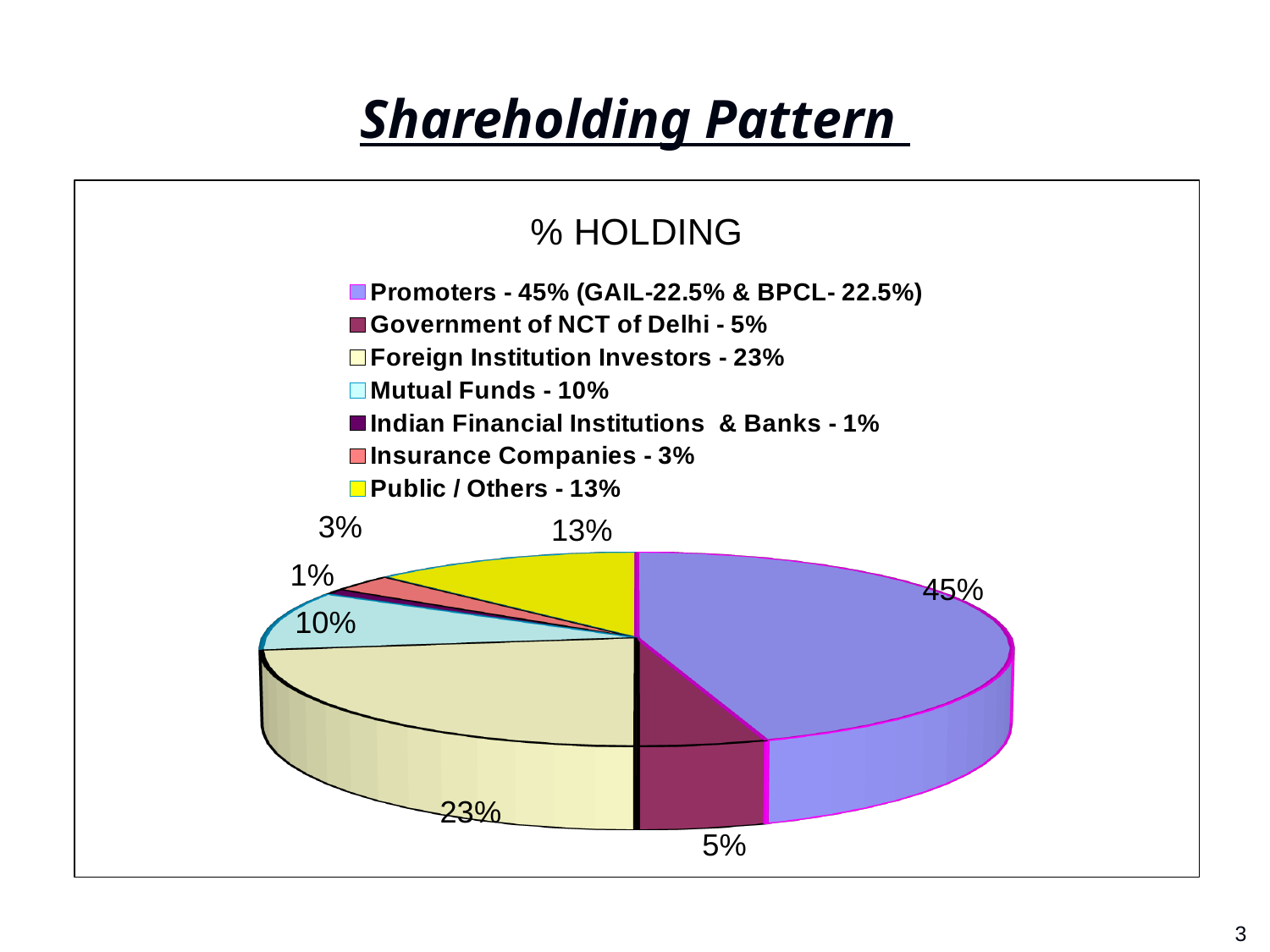
Which has a larger share, Public / Others or Mutual Funds? Public / Others What share of holding do Mutual Funds have? 10% What share of holding do Promoters have? 45% What kind of chart is shown on the slide? pie chart What is the difference between the Promoters' share and the Foreign Institution Investors' share? 22% What share of holding do Foreign Institution Investors have? 23% How many categories does the legend list? 7 What is the combined share of Insurance Companies and Indian Financial Institutions & Banks? 4% What is the chart's title? % HOLDING What share of holding does the Government of NCT of Delhi have? 5% Which category has the largest share of holding? Promoters Which category has the smallest share of holding? Indian Financial Institutions & Banks